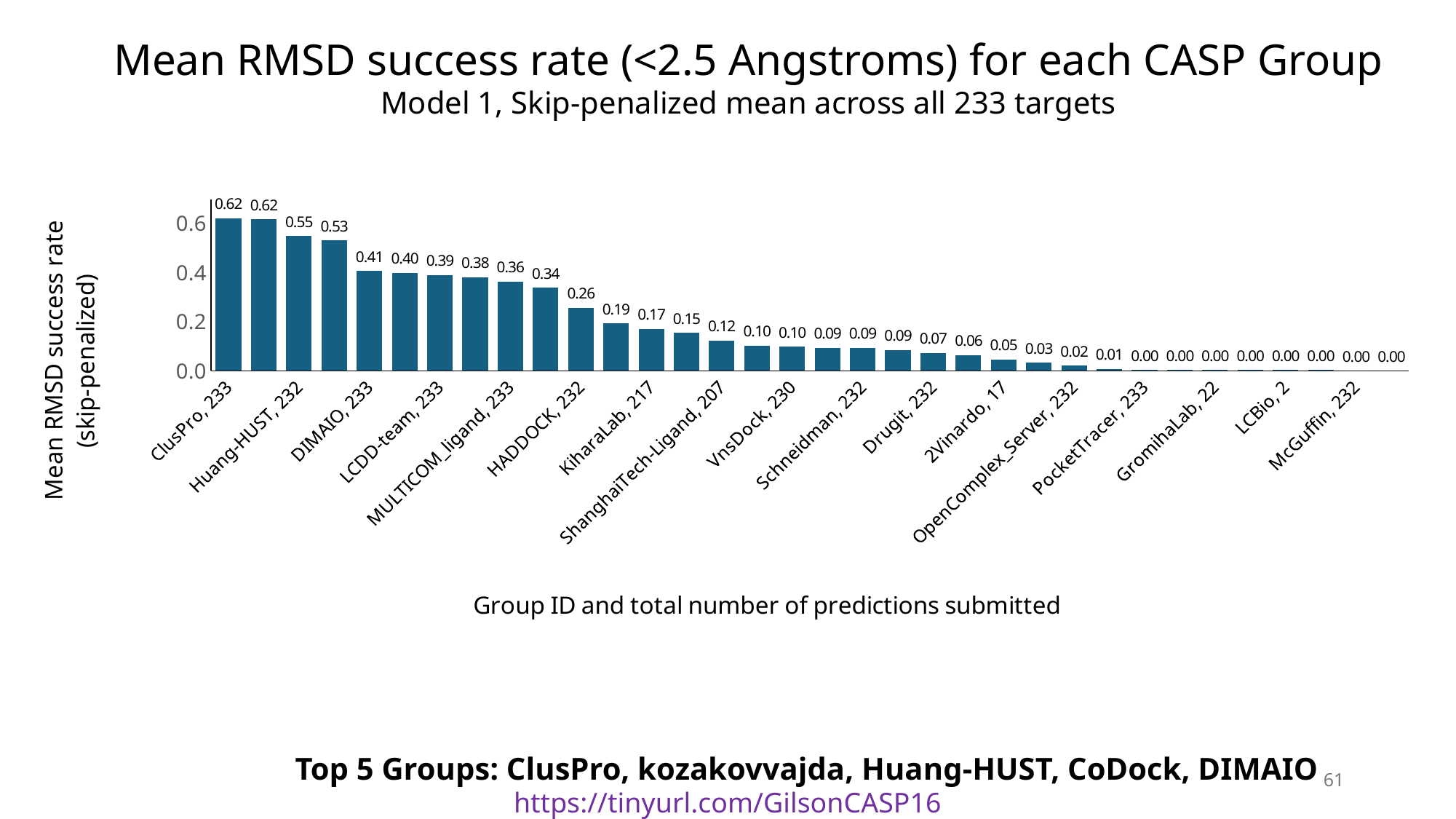
What is the mean RMSD success rate for Huang-HUST, 232? 0.55 Is the value for HADDOCK, 232 greater or less than 0.2? greater How many bars are plotted on the chart? 34 What is the difference between the success rates of ClusPro, 233 and Huang-HUST, 232? 0.07 What is the mean RMSD success rate for HADDOCK, 232? 0.26 What is the mean RMSD success rate for ClusPro, 233? 0.62 What is the subtitle of the chart? Model 1, Skip-penalized mean across all 233 targets Do the values rise or fall from left to right along the x axis? fall What kind of chart is shown on the slide? bar chart What is the label of the x axis? Group ID and total number of predictions submitted Which has the higher mean RMSD success rate, KiharaLab, 217 or VnsDock, 230? KiharaLab, 217 What is the highest mean RMSD success rate shown on the chart? 0.62